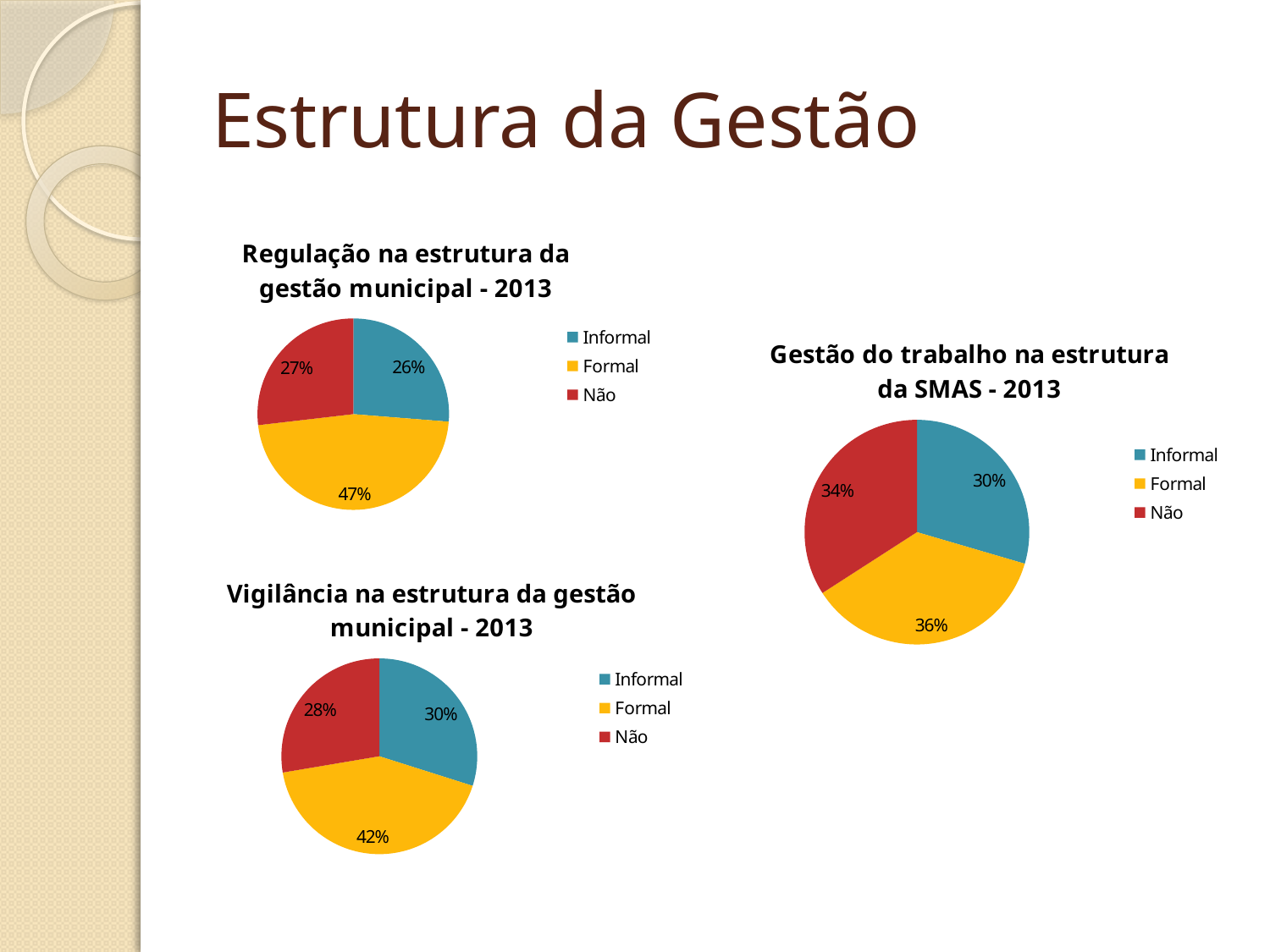
In the chart 'Vigilância na estrutura da gestão municipal - 2013', what share does Formal have? 42% In the chart 'Regulação na estrutura da gestão municipal - 2013', which category has the largest slice? Formal How many categories does the legend of the chart 'Gestão do trabalho na estrutura da SMAS - 2013' list? 3 In the chart 'Regulação na estrutura da gestão municipal - 2013', what share does Formal have? 47% In the chart 'Vigilância na estrutura da gestão municipal - 2013', which is larger, Informal or Não? Informal In the chart 'Gestão do trabalho na estrutura da SMAS - 2013', what share does Formal have? 36% In the chart 'Gestão do trabalho na estrutura da SMAS - 2013', which category has the smallest slice? Informal In the chart 'Vigilância na estrutura da gestão municipal - 2013', what share does Não have? 28% In the chart 'Regulação na estrutura da gestão municipal - 2013', what share does Informal have? 26% What type of chart is used for 'Vigilância na estrutura da gestão municipal - 2013'? Pie chart In the chart 'Gestão do trabalho na estrutura da SMAS - 2013', what share does Não have? 34% In the chart 'Regulação na estrutura da gestão municipal - 2013', what is the difference between the Formal and Não shares? 20%